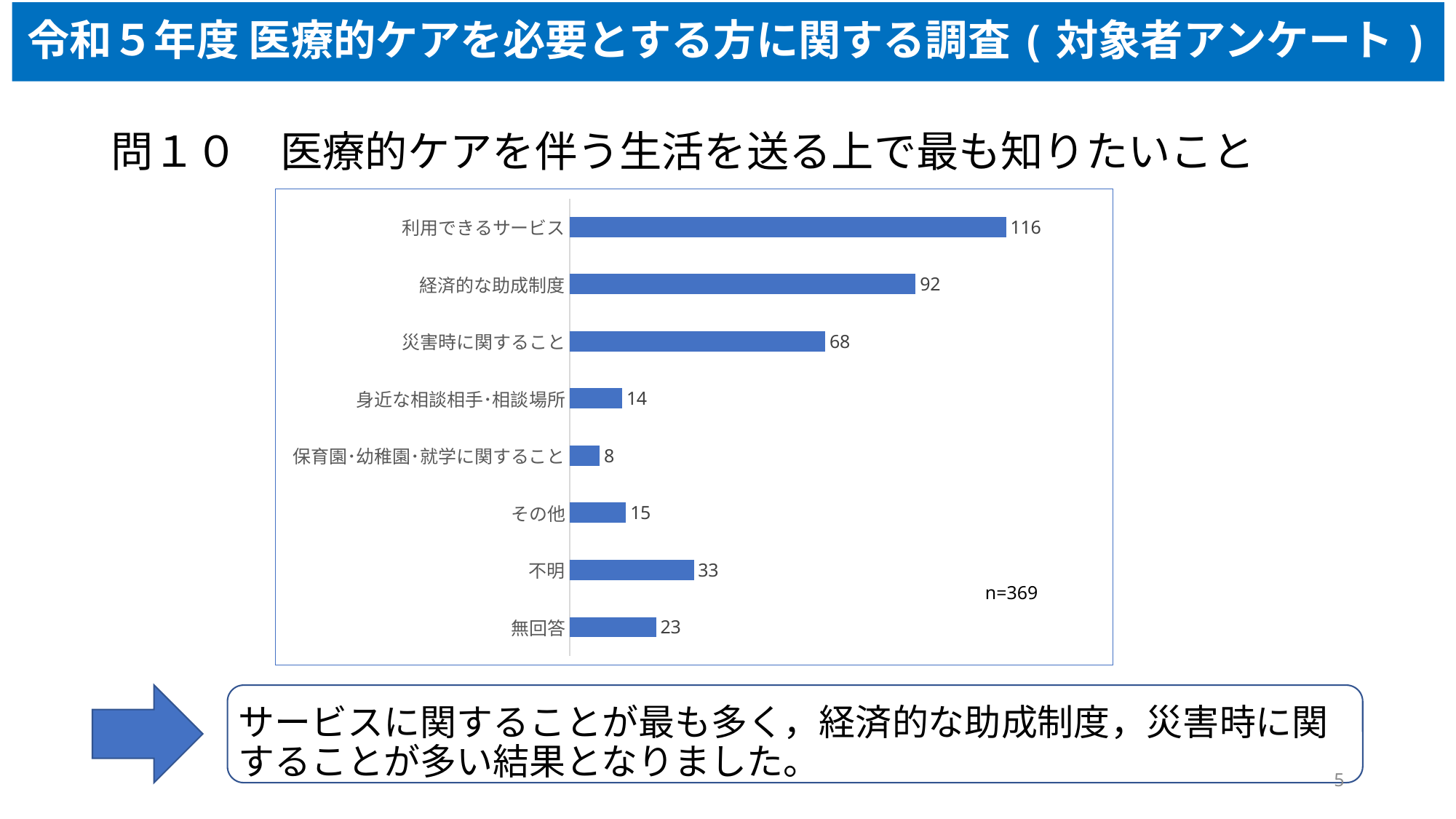
Which is larger, the value for その他 or the value for 身近な相談相手･相談場所? その他 Which category has the highest value? 利用できるサービス What is the value for 経済的な助成制度? 92 What is the value for 保育園･幼稚園･就学に関すること? 8 Which category has the lowest value? 保育園･幼稚園･就学に関すること What kind of chart is shown on the slide? Bar chart What is the difference between the values for 利用できるサービス and 経済的な助成制度? 24 What is the difference between the values for 不明 and 無回答? 10 What is the value for 災害時に関すること? 68 What is the value for 利用できるサービス? 116 How many categories are shown in the chart? 8 What sample size (n) is shown on the chart? n=369